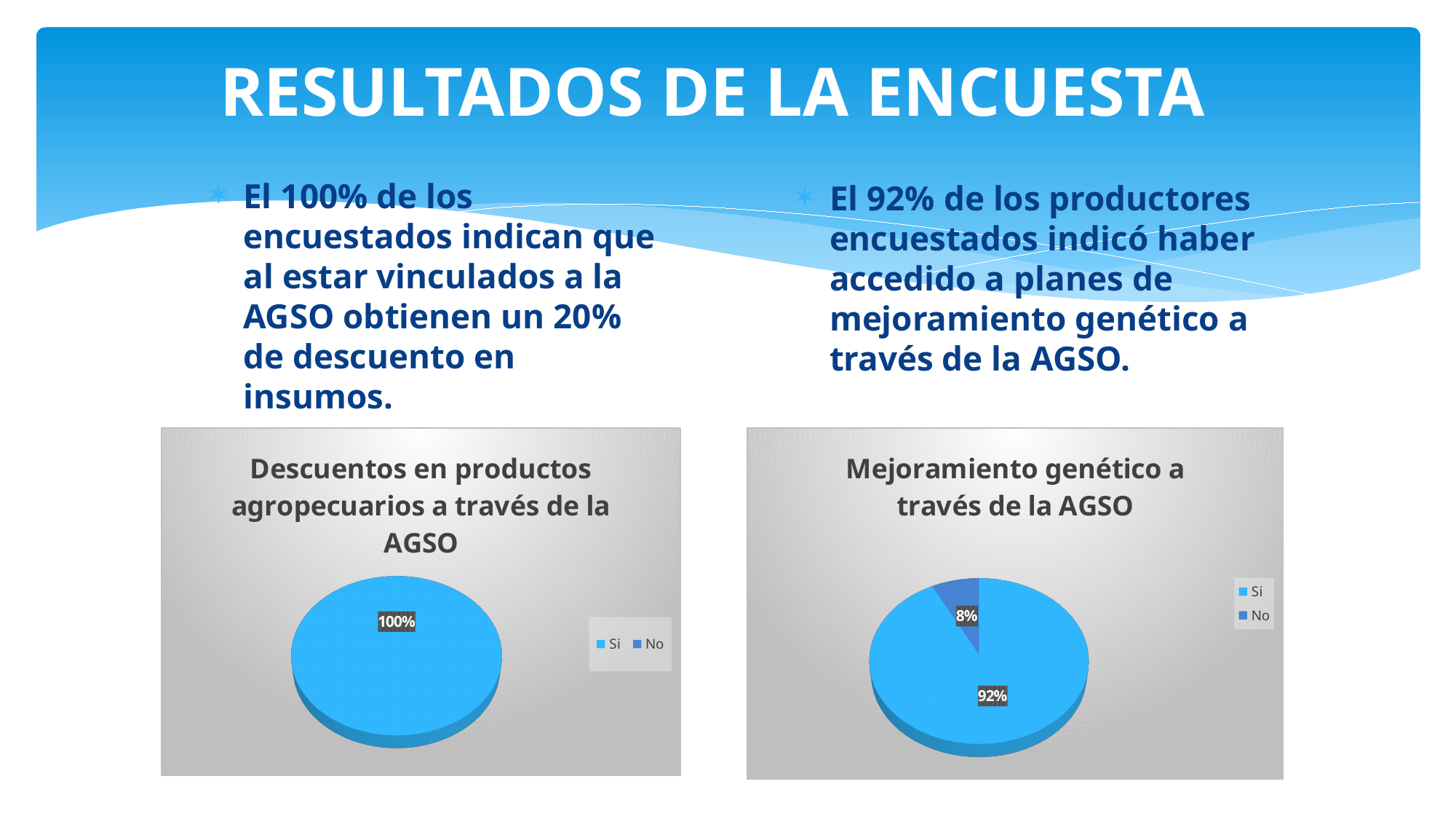
What type of chart is the one on the right of the slide? Pie chart In the chart titled "Mejoramiento genético a través de la AGSO", which is larger, the "Si" slice or the "No" slice? Si In the chart titled "Descuentos en productos agropecuarios a través de la AGSO", what share of the pie is labelled for "Si"? 100% In the chart titled "Mejoramiento genético a través de la AGSO", which category has the smallest slice? No How many entries does the legend list in the chart titled "Descuentos en productos agropecuarios a través de la AGSO"? 2 In the chart titled "Mejoramiento genético a través de la AGSO", what share of the pie is "Si"? 92% In the chart titled "Mejoramiento genético a través de la AGSO", what is the difference between the "Si" and "No" shares? 84% In the chart titled "Mejoramiento genético a través de la AGSO", which category has the largest slice? Si In the chart titled "Mejoramiento genético a través de la AGSO", what share of the pie is "No"? 8% What is the title of the chart on the right of the slide? Mejoramiento genético a través de la AGSO In the chart titled "Mejoramiento genético a través de la AGSO", what colour is the "No" slice? Dark blue What type of chart is the one on the left of the slide? Pie chart